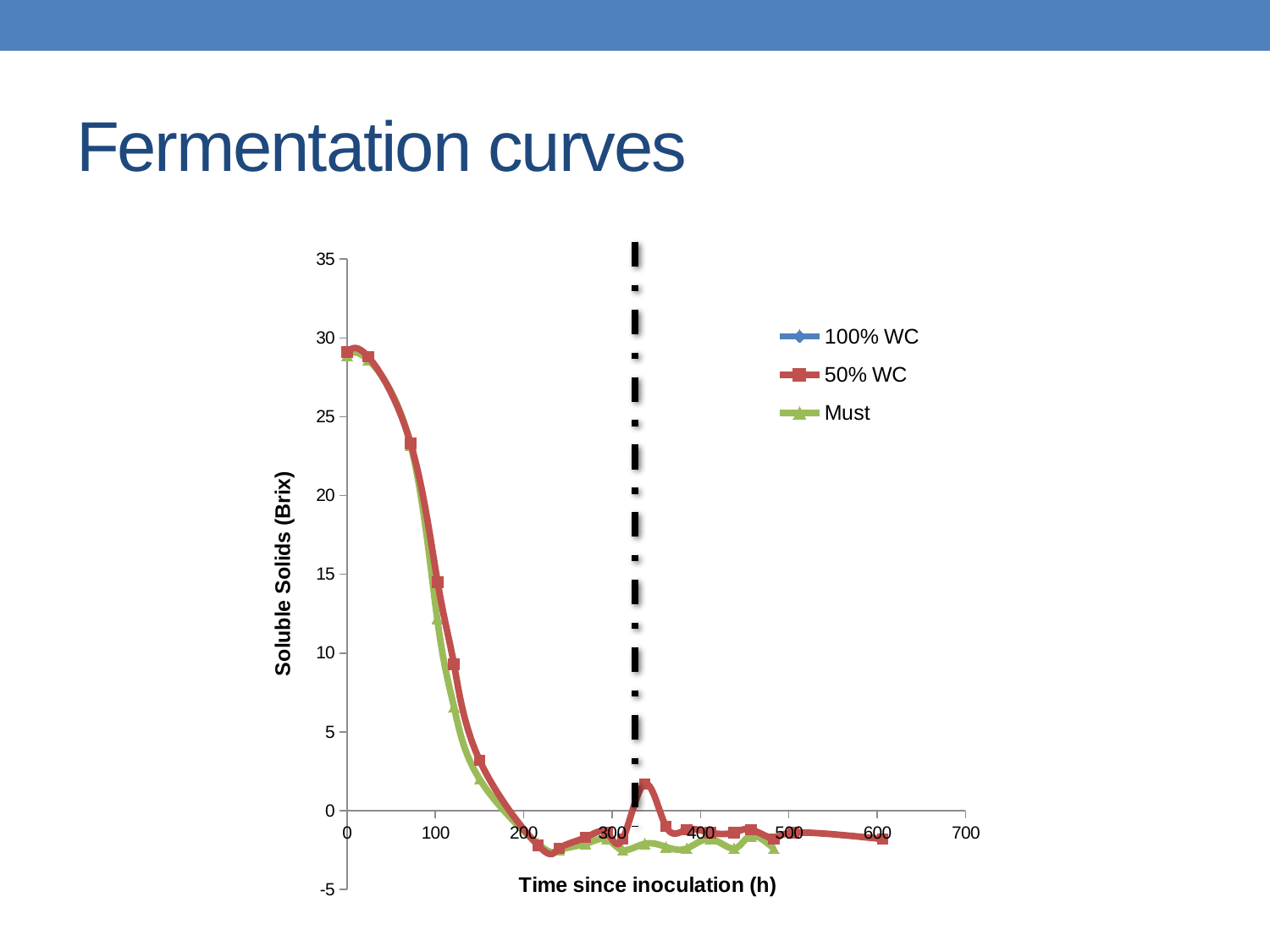
Is the value for 50% WC at 75 h greater or less than 20? greater Is the value for 50% WC at 100 h greater or less than 10? greater What is the label of the y axis? Soluble Solids (Brix) How many series does the legend list? 3 Is the value for 50% WC at 0 h greater or less than 25? greater What kind of chart is shown on the slide? line chart At 100 h, which series has the higher soluble solids value, 50% WC or Must? 50% WC What is the title of the slide? Fermentation curves Do the soluble solids values rise or fall as time since inoculation increases from 0 to 200 h? fall